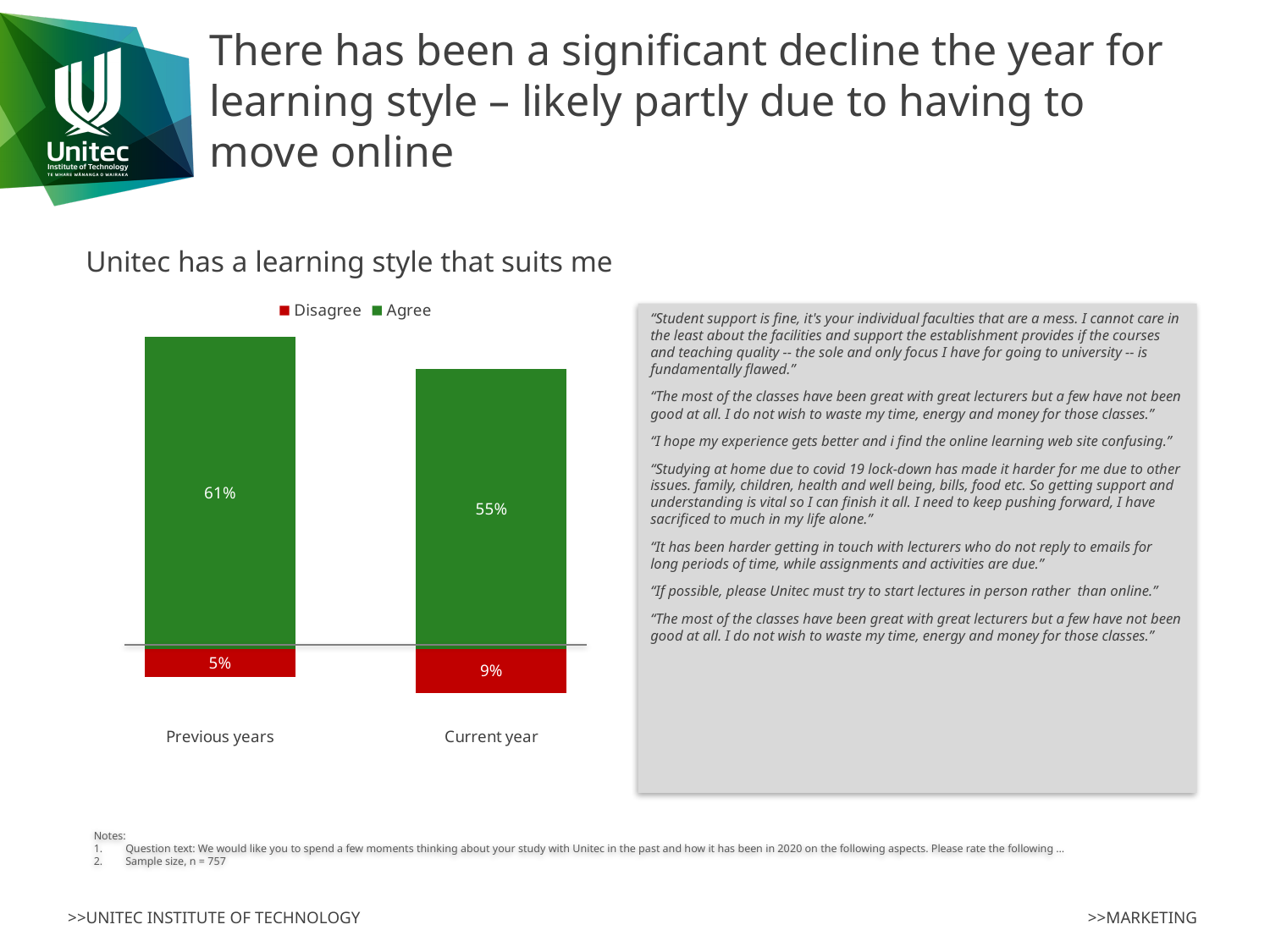
What is the Agree value for Previous years? 61% How many series does the legend list? 2 Which category has the lower Disagree value? Previous years What is the difference between the Disagree values for Current year and Previous years? 4% Which category has the higher Agree value? Previous years What is the Agree value for Current year? 55% What kind of chart is shown? bar chart How many categories are shown on the x axis? 2 What is the difference between the Agree values for Previous years and Current year? 6% What is the Disagree value for Previous years? 5% Is the Disagree value for Current year larger or smaller than the Disagree value for Previous years? larger What is the Disagree value for Current year? 9%